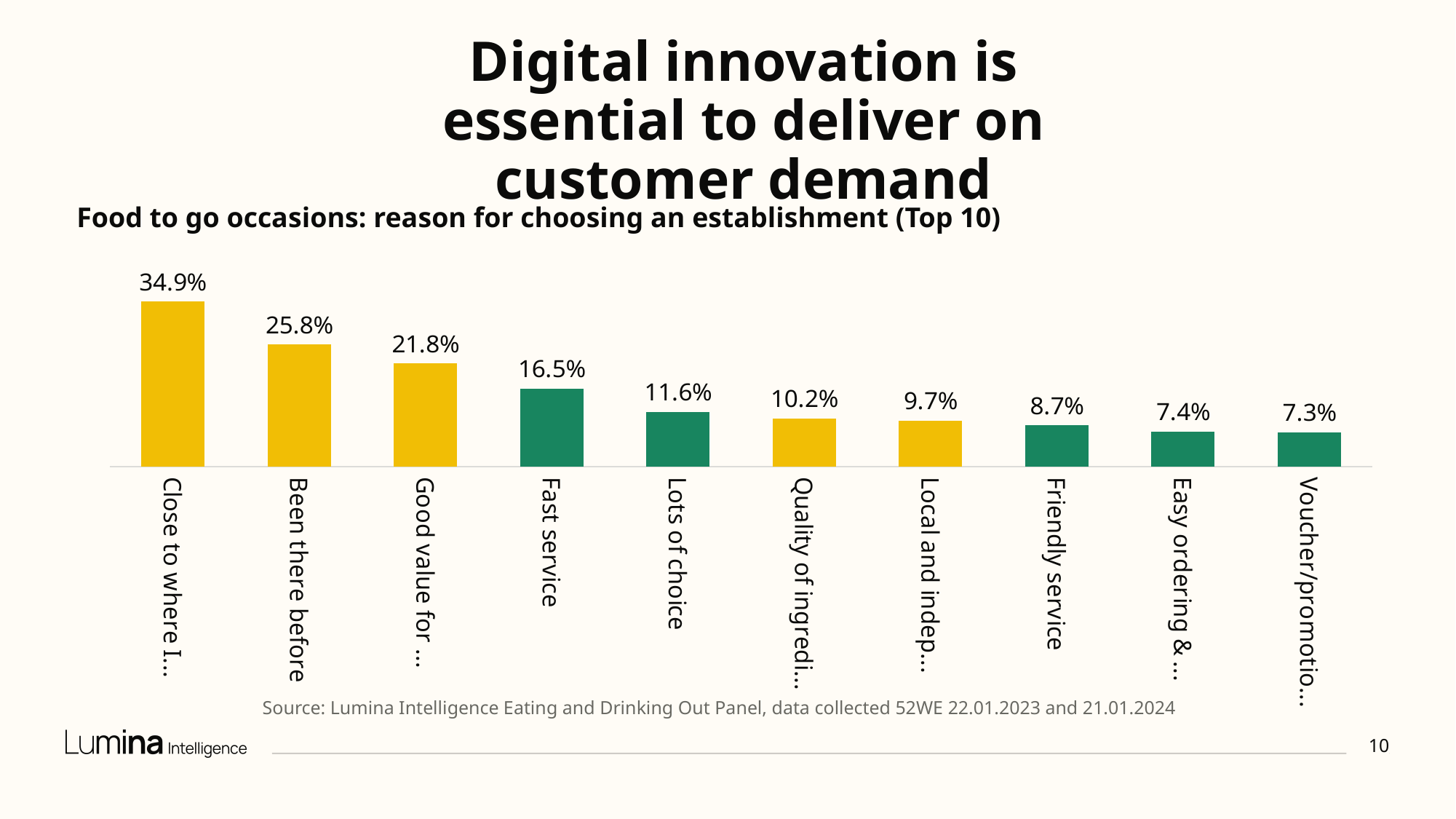
How many categories are shown in the chart? 10 What is the value for Lots of choice? 11.6% What is the difference between the values for Been there before and Fast service? 9.3% What kind of chart is shown on the slide? bar chart What is the value for Been there before? 25.8% What is the value for Fast service? 16.5% Which is larger, the value for Lots of choice or the value for Friendly service? Lots of choice What is the value for Friendly service? 8.7% Which category has the lowest value? Voucher/promotio... What is the title of the chart? Food to go occasions: reason for choosing an establishment (Top 10) Which category has the highest value? Close to where I... What is the value of the first (leftmost) bar, labelled 'Close to where I...'? 34.9%